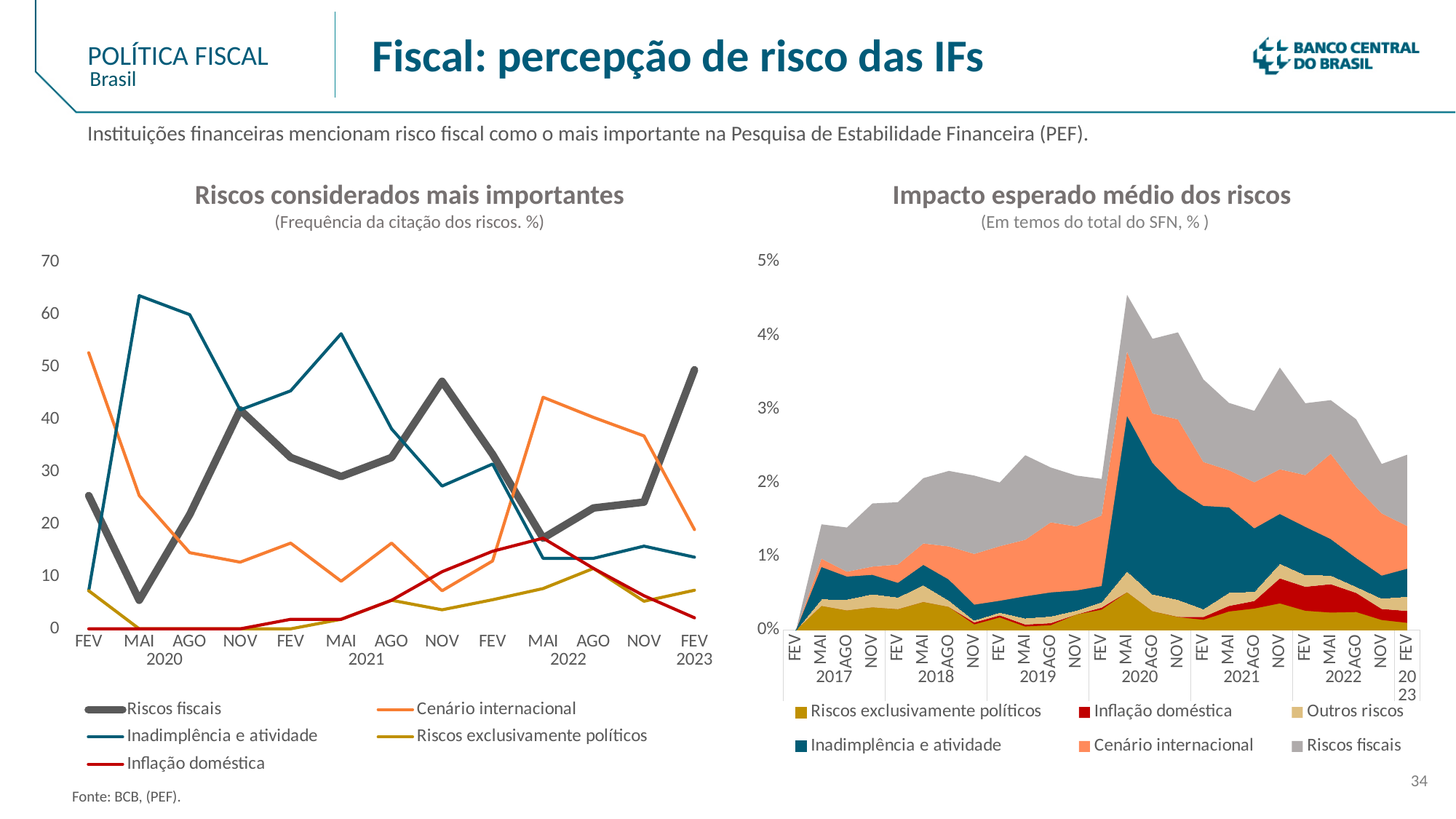
In the left chart, 'Riscos considerados mais importantes', which is larger at FEV 2023: Riscos fiscais or Cenário internacional? Riscos fiscais In the left chart, 'Riscos considerados mais importantes', how many time points are plotted along the x axis? 13 What kind of chart is the left chart, 'Riscos considerados mais importantes'? Line chart In the left chart, 'Riscos considerados mais importantes', which series has the highest value at MAI 2020? Inadimplência e atividade How many series does the legend of the left chart, 'Riscos considerados mais importantes', list? 5 How many series does the legend of the right chart, 'Impacto esperado médio dos riscos', list? 6 In the right chart, 'Impacto esperado médio dos riscos', is the total stacked value at MAI 2020 greater or less than 4%? greater In the left chart, 'Riscos considerados mais importantes', which series has the highest value at FEV 2023? Riscos fiscais In the left chart, 'Riscos considerados mais importantes', is the value for Riscos fiscais at FEV 2023 greater or less than 40? greater In the left chart, 'Riscos considerados mais importantes', is the value for Riscos fiscais at MAI 2020 greater or less than 10? less In the left chart, 'Riscos considerados mais importantes', which series is drawn with the thick dark grey line? Riscos fiscais What kind of chart is the right chart, 'Impacto esperado médio dos riscos'? Stacked area chart